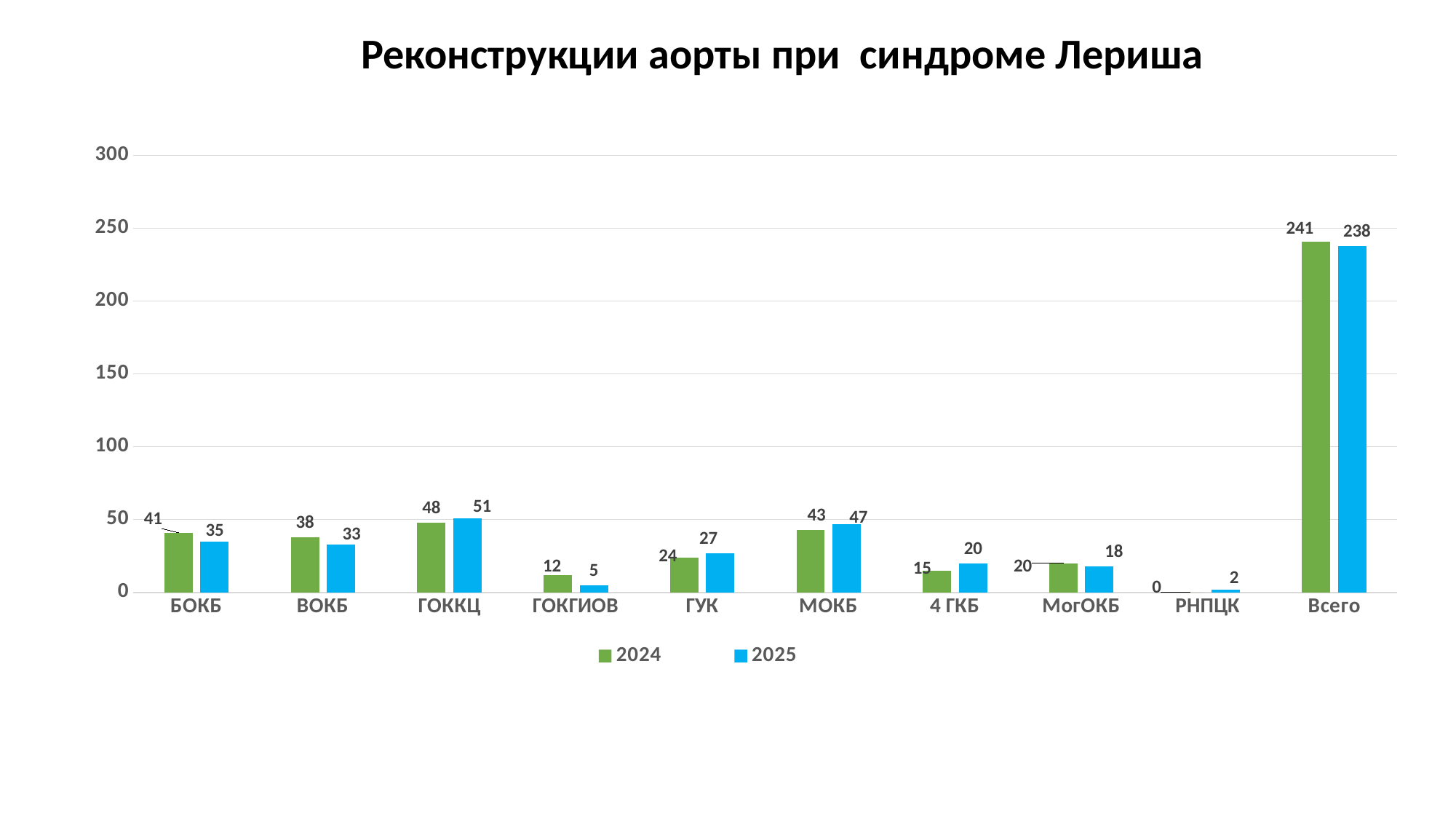
What is the title of the chart? Реконструкции аорты при синдроме Лериша Which category has the lowest 2024 value? РНПЦК What is the 2025 value for ГОКГИОВ? 5 What kind of chart is shown on the slide? Bar chart What is the 2025 value for Всего? 238 What is the 2024 value for ГОККЦ? 48 What is the difference between the 2024 and 2025 values for Всего? 3 Excluding Всего, which category has the highest 2025 value? ГОККЦ Which is larger for МОКБ, the 2024 value or the 2025 value? 2025 How many categories are shown on the x axis? 10 What is the difference between the 2024 and 2025 values for БОКБ? 6 How many series does the legend list? 2